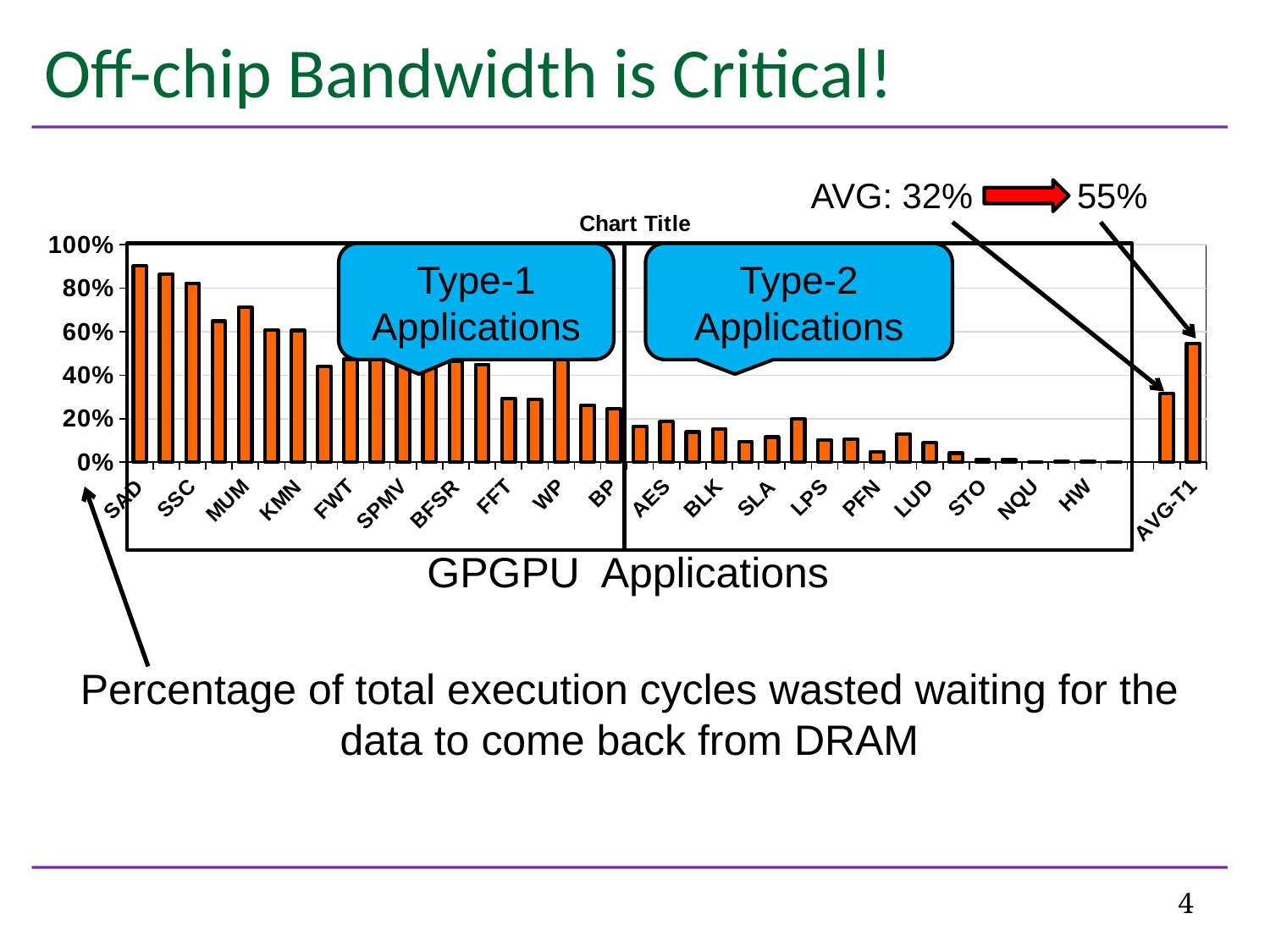
According to the annotation, what is the average value for the AVG-T1 bar? 55% Is the value for FFT greater or less than 20%? greater Is the value for FWT greater or less than 40%? greater Is the value for HW greater or less than 20%? less What kind of chart is shown on the slide? bar chart Which is larger, the value for BLK or the value for SSC? SSC Which application has the highest bar in the chart? SAD What is the x-axis label of the chart? GPGPU Applications Which is larger, the value for SAD or the value for AES? SAD